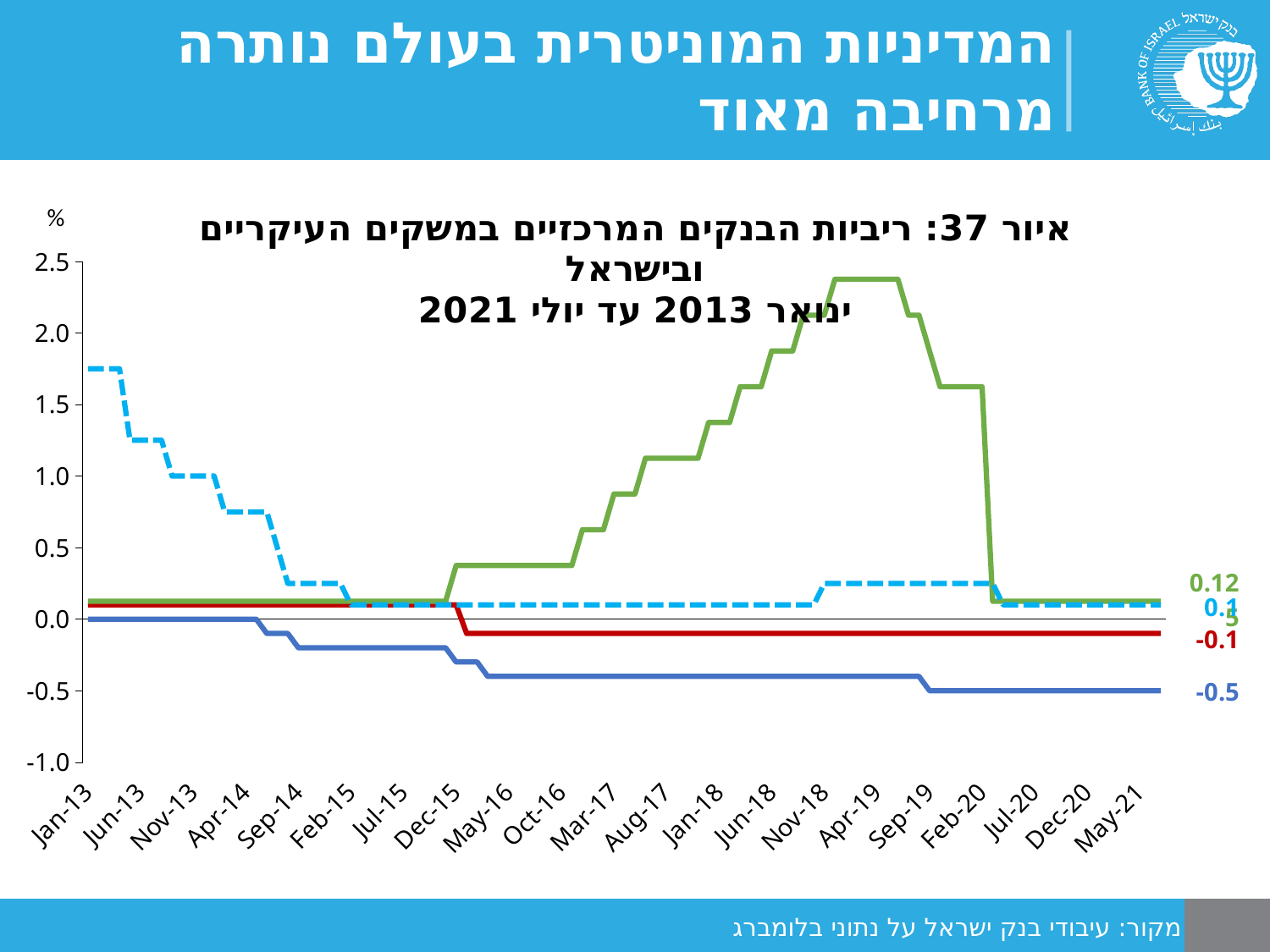
Which line has the lowest value at the end of the period? the solid blue line What is the value labelled at the end of the green line? 0.12 Does the dashed blue line rise or fall between Jan-13 and Feb-15? fall Is the value of the dashed blue line at Jan-13 greater or less than 1.5? greater What unit is shown at the top of the vertical axis? % What is the difference between the end values of the red line (-0.1) and the solid blue line (-0.5)? 0.4 Which line reaches the highest value on the chart? the green line How many lines are plotted on the chart? 4 What kind of chart is shown on the slide? line chart Is the peak value of the green line greater or less than 2.0? greater What is the value labelled at the end of the solid blue line? -0.5 What is the value labelled at the end of the red line? -0.1